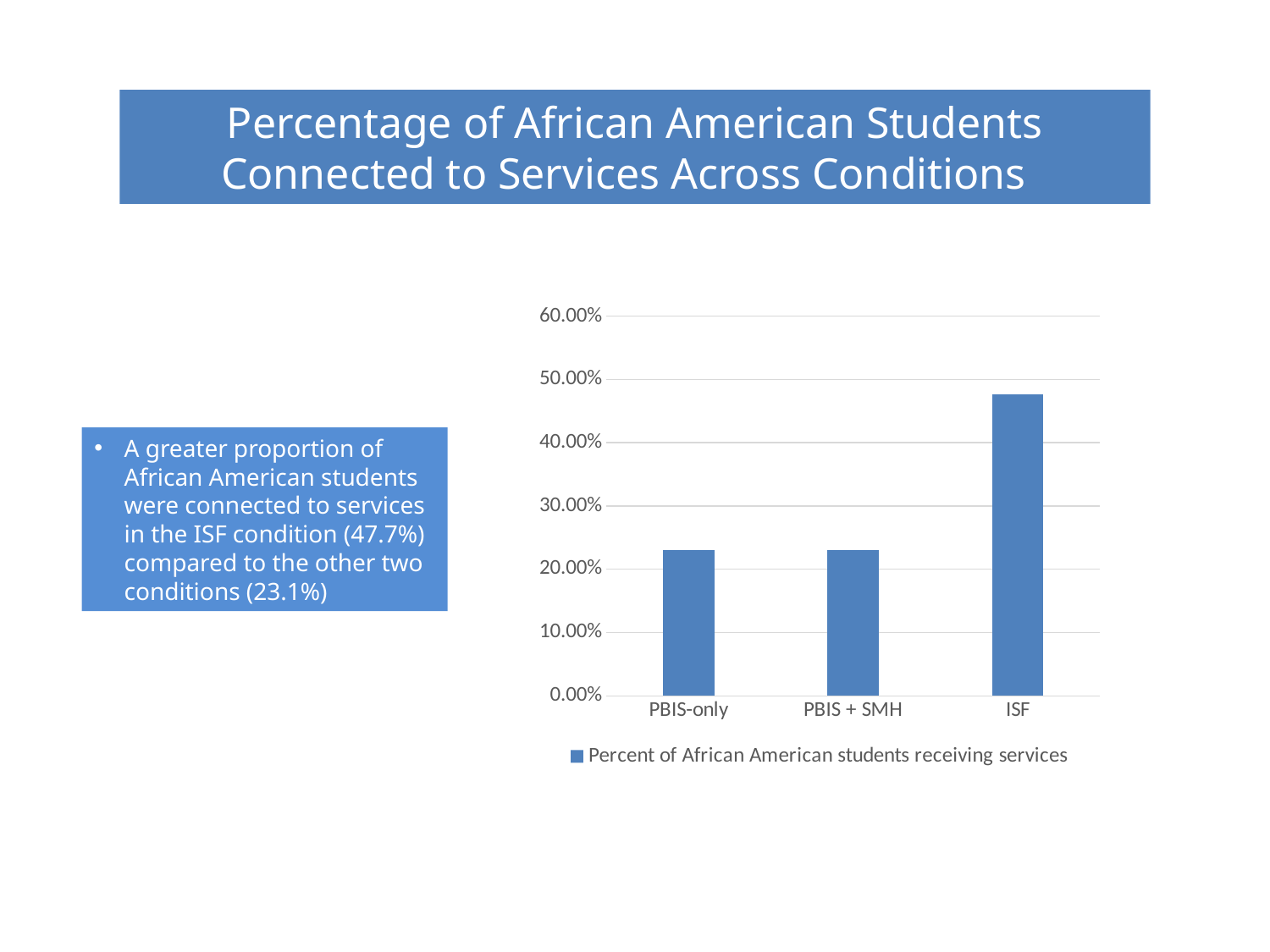
What kind of chart is shown on the slide? bar chart What is the series name shown in the chart's legend? Percent of African American students receiving services Which is larger, the value for PBIS-only or the value for ISF? ISF Is the value for ISF greater or less than 40.00%? greater Is the value for PBIS-only greater or less than 20.00%? greater What is the title of the slide containing the chart? Percentage of African American Students Connected to Services Across Conditions Is the value for ISF greater or less than 50.00%? less Which is larger, the value for ISF or the value for PBIS + SMH? ISF How many series does the chart's legend list? 1 Which condition has the highest percentage of African American students receiving services? ISF How many conditions (categories) are shown on the x axis of the chart? 3